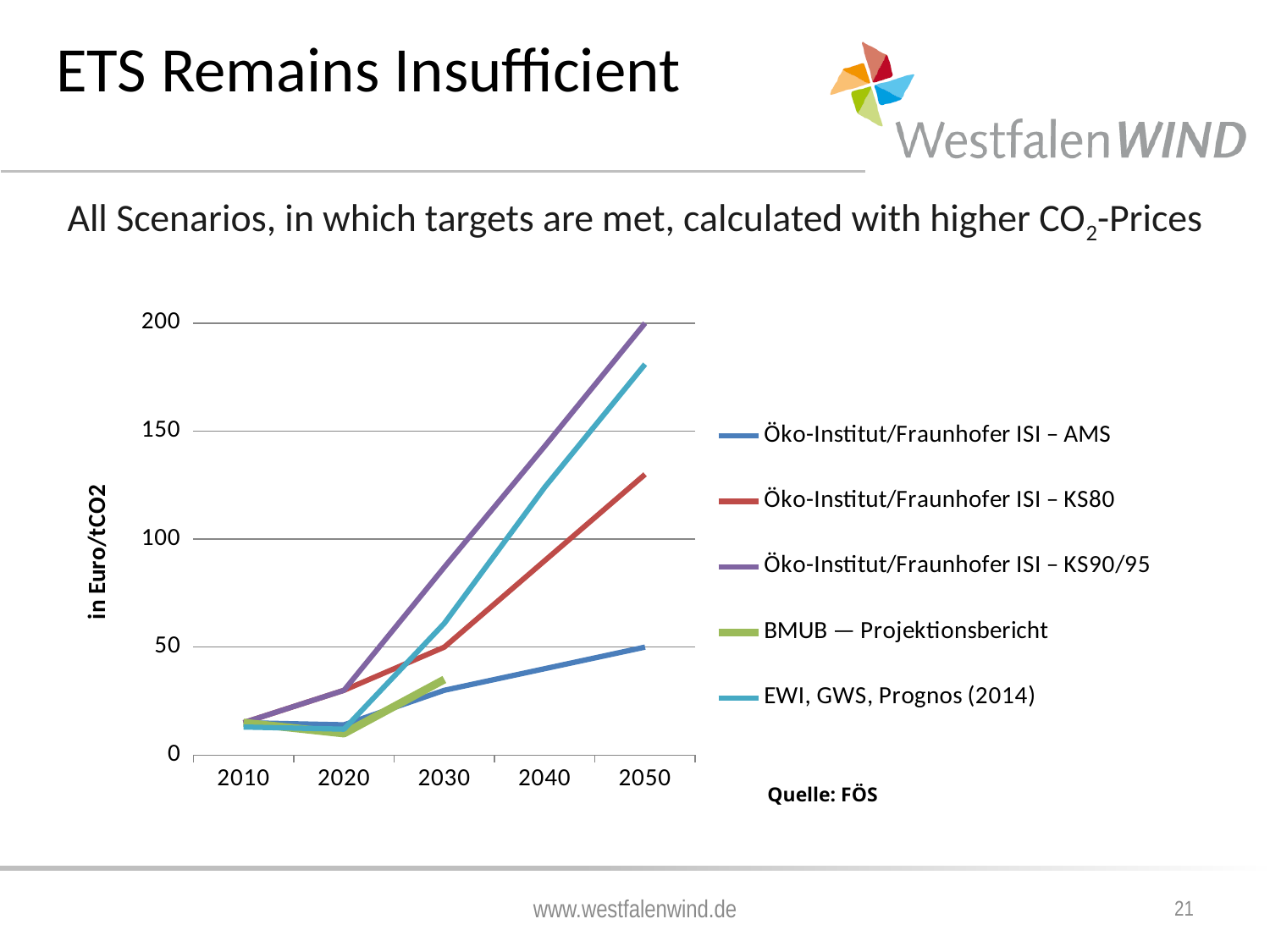
What kind of chart is shown on the slide? line chart What is the label on the y axis of the chart? in Euro/tCO2 Is the value for Öko-Institut/Fraunhofer ISI – KS90/95 in 2030 greater or less than 50? greater Is the value for Öko-Institut/Fraunhofer ISI – KS80 in 2050 greater or less than 100? greater Is the value for Öko-Institut/Fraunhofer ISI – AMS in 2050 greater or less than 100? less Which series has the highest value in 2050? Öko-Institut/Fraunhofer ISI – KS90/95 How many years are labelled on the x axis? 5 How many series does the legend list? 5 Which series has the lowest value in 2050? Öko-Institut/Fraunhofer ISI – AMS Does the Öko-Institut/Fraunhofer ISI – KS90/95 series rise or fall from 2020 to 2050? rise In 2050, which is larger: the value for EWI, GWS, Prognos (2014) or the value for Öko-Institut/Fraunhofer ISI – KS80? EWI, GWS, Prognos (2014)